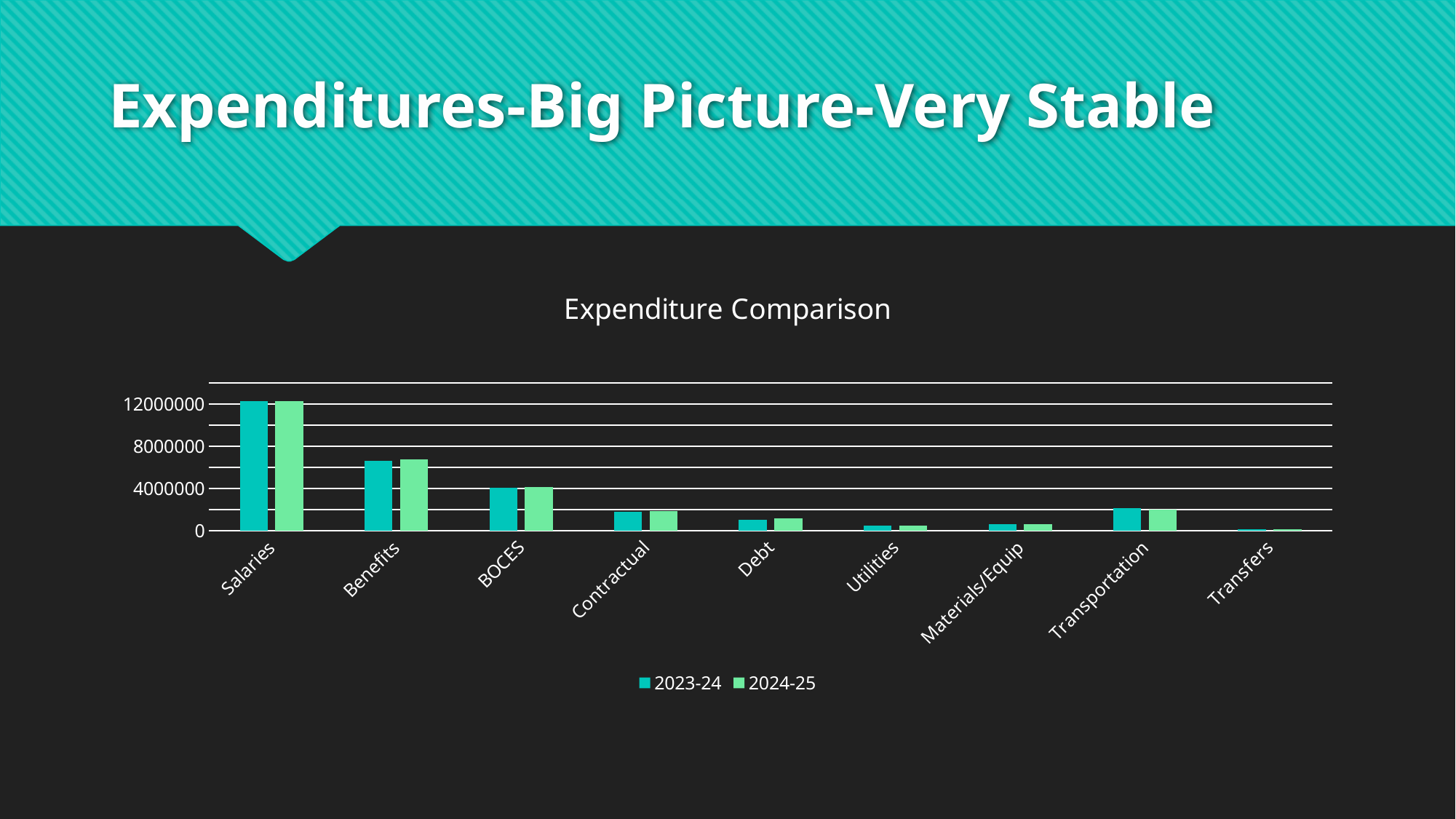
Which is larger for 2024-25, Debt or Utilities? Debt Is the 2024-25 value for Contractual greater or less than 4000000? less What is the title of the chart? Expenditure Comparison What kind of chart is shown on the slide? bar chart Is the 2024-25 value for Benefits greater or less than 8000000? less Which category has the lowest expenditure? Transfers Is the 2023-24 value for Salaries greater or less than 8000000? greater How many series does the legend list? 2 Which category has the highest expenditure? Salaries Which is larger for 2023-24, Benefits or BOCES? Benefits How many expenditure categories are shown on the x axis? 9